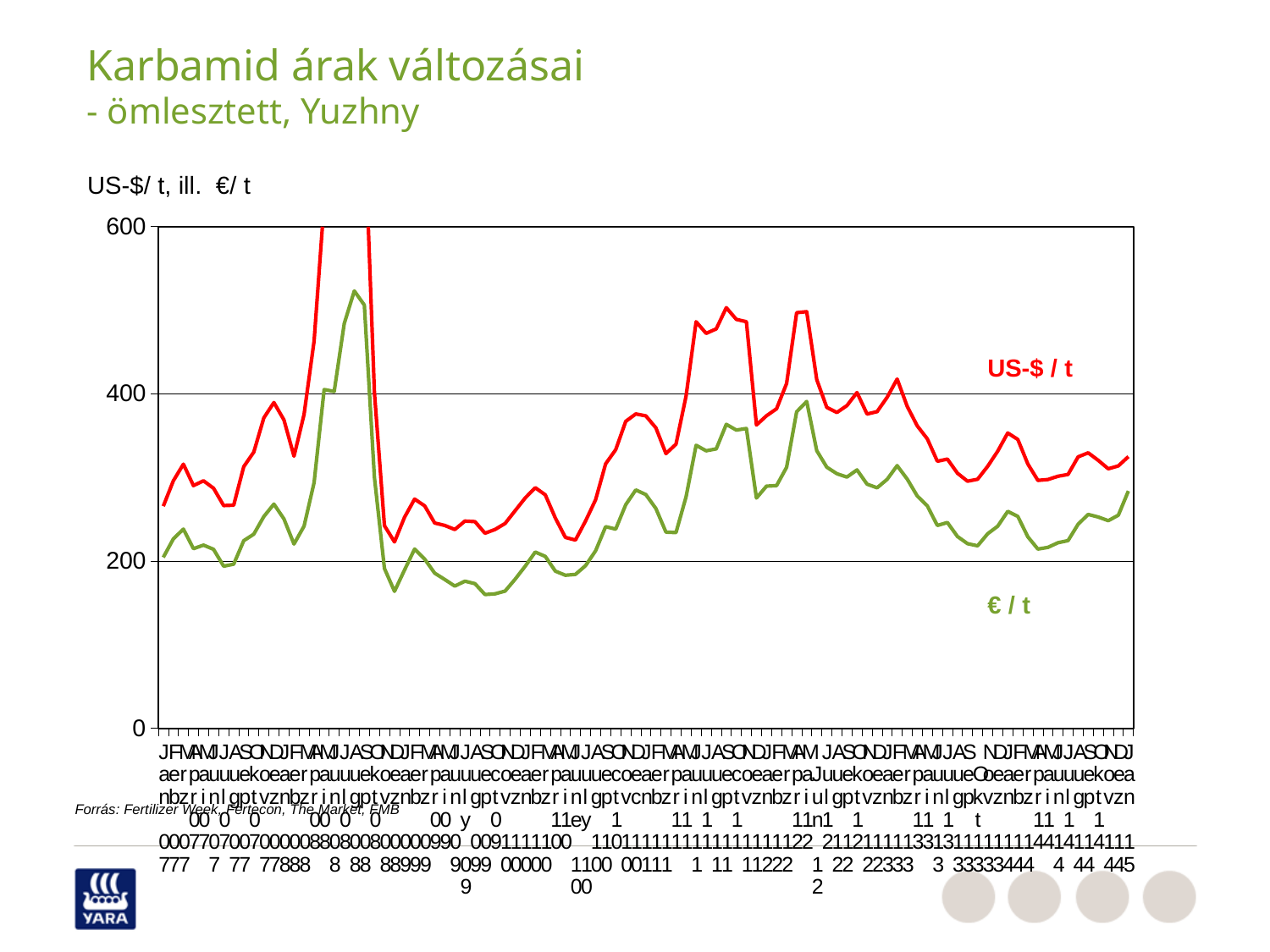
Is the lowest point of the € / t series greater or less than 200? less Is the highest peak of the US-$ / t series greater or less than 600? greater Immediately after the highest peak of the US-$ / t series, do the values rise or fall? fall Is the last plotted value of the € / t series greater or less than 200? greater What is the title of the chart on the slide? Karbamid árak változásai - ömlesztett, Yuzhny Which series lies higher on the chart throughout the period, US-$ / t or € / t? US-$ / t What kind of chart is shown on the slide? line chart How many series are plotted on the chart? 2 Which colour is used for the US-$ / t series? red